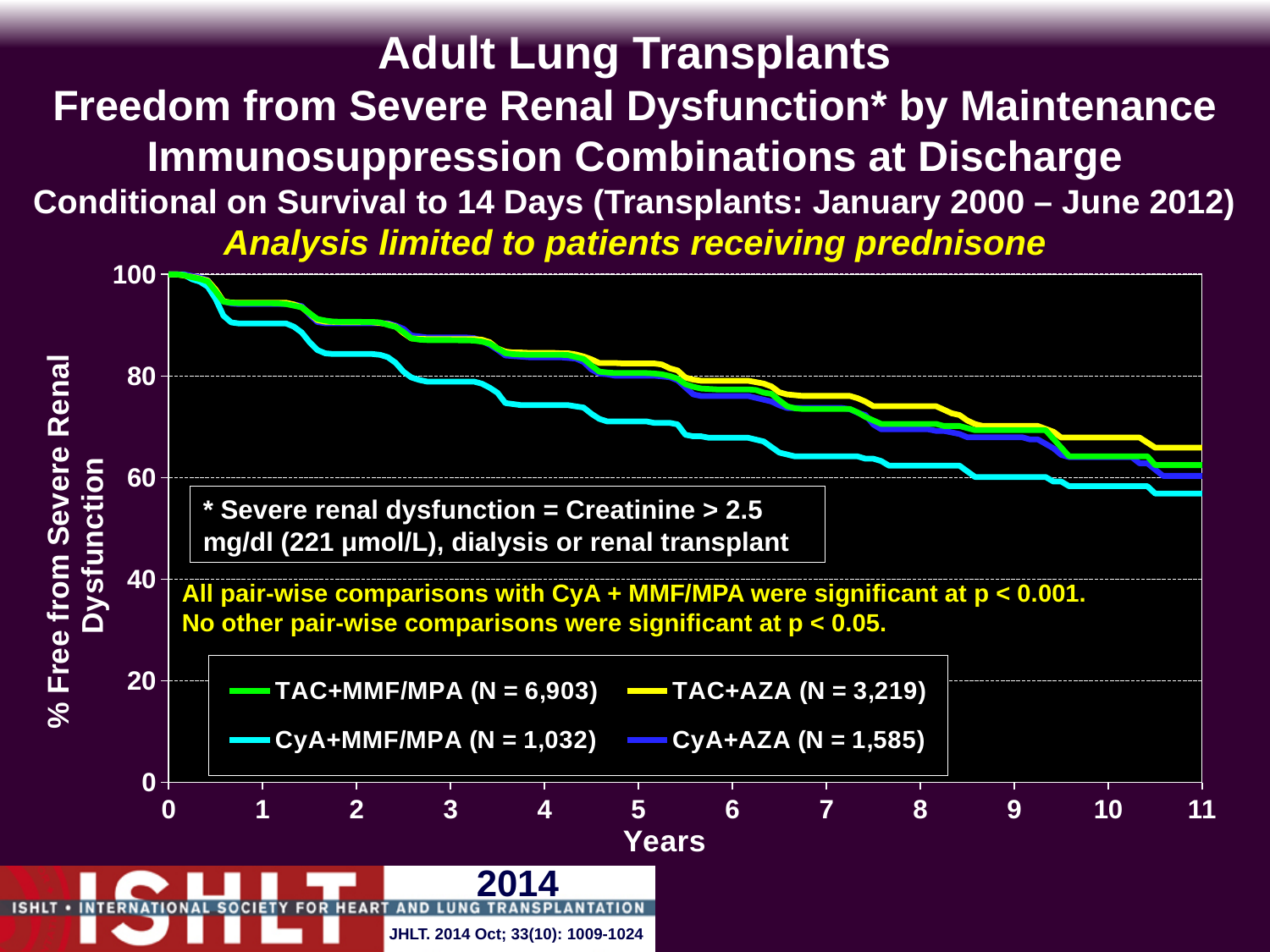
Do the values rise or fall as years since transplant increase? fall What kind of chart is shown on the slide? line chart Is the value for CyA+MMF/MPA at 11 years greater or less than 60? less Is the value for TAC+AZA at 11 years greater or less than 60? greater Is the value for CyA+MMF/MPA at 5 years greater or less than 80? less How many series does the legend list? 4 What is the N for the TAC+MMF/MPA group shown in the legend? 6,903 At 8 years, which is larger: the value for TAC+AZA or the value for CyA+MMF/MPA? TAC+AZA What is the label of the y axis? % Free from Severe Renal Dysfunction Which series has the lowest freedom from severe renal dysfunction across the follow-up period? CyA+MMF/MPA Which series has the highest freedom from severe renal dysfunction at 11 years? TAC+AZA